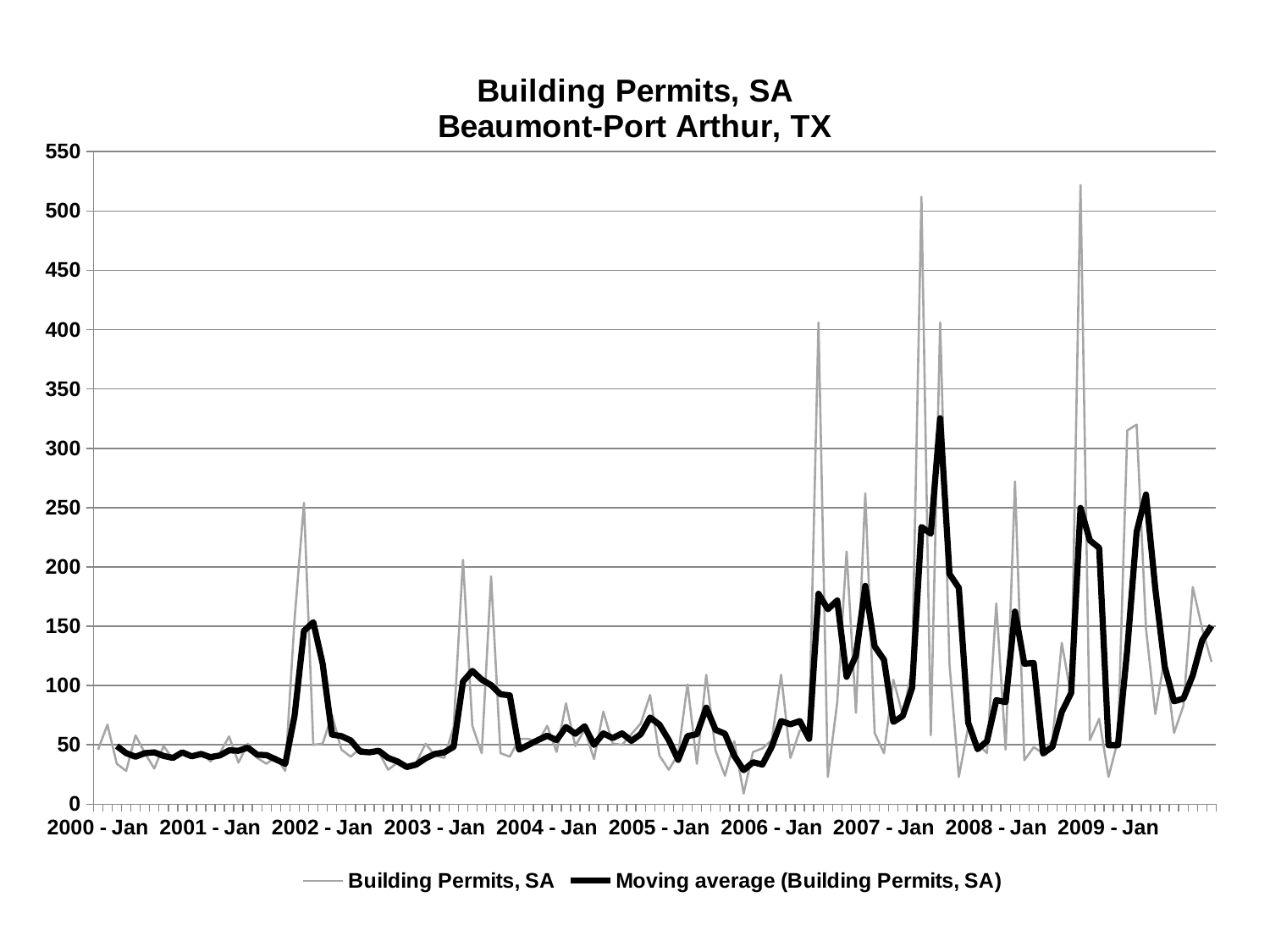
How many year labels are shown along the x axis? 10 Which series reaches higher peaks, Building Permits, SA or the Moving average? Building Permits, SA What is the title of the chart? Building Permits, SA Beaumont-Port Arthur, TX Are the Moving average values generally higher in 2007-2009 or in 2000-2001? 2007-2009 Is the Moving average line during 2003 greater or less than 150? less Is the highest peak of the Building Permits, SA line greater or less than 500? greater Is the peak of the Building Permits, SA line in early 2002 greater or less than 200? greater How many series does the legend list? 2 What is the highest value shown on the vertical axis? 550 Which series is drawn with the thick black line? Moving average (Building Permits, SA) What kind of chart is shown on the slide? Line chart